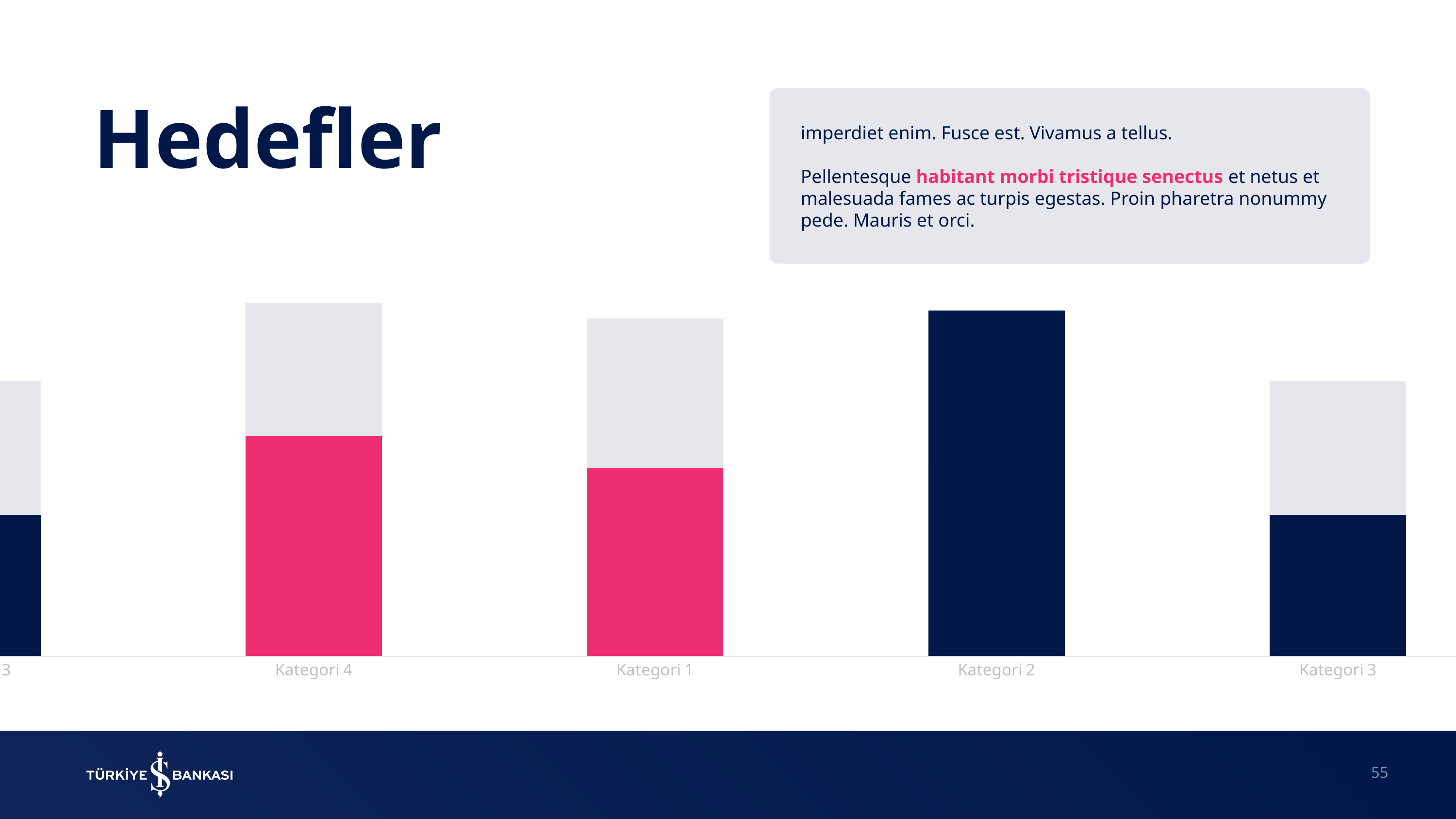
Which category's bar is taller overall, Kategori 4 or Kategori 3? Kategori 4 Does the chart display a legend? No Which category has the taller dark navy segment, Kategori 2 or Kategori 3? Kategori 2 Which category has the taller pink segment, Kategori 4 or Kategori 1? Kategori 4 Which categories have a pink lower segment in their bars? Kategori 4 and Kategori 1 What kind of chart is shown on the slide? Bar chart Which category's bar has no light grey segment on top? Kategori 2